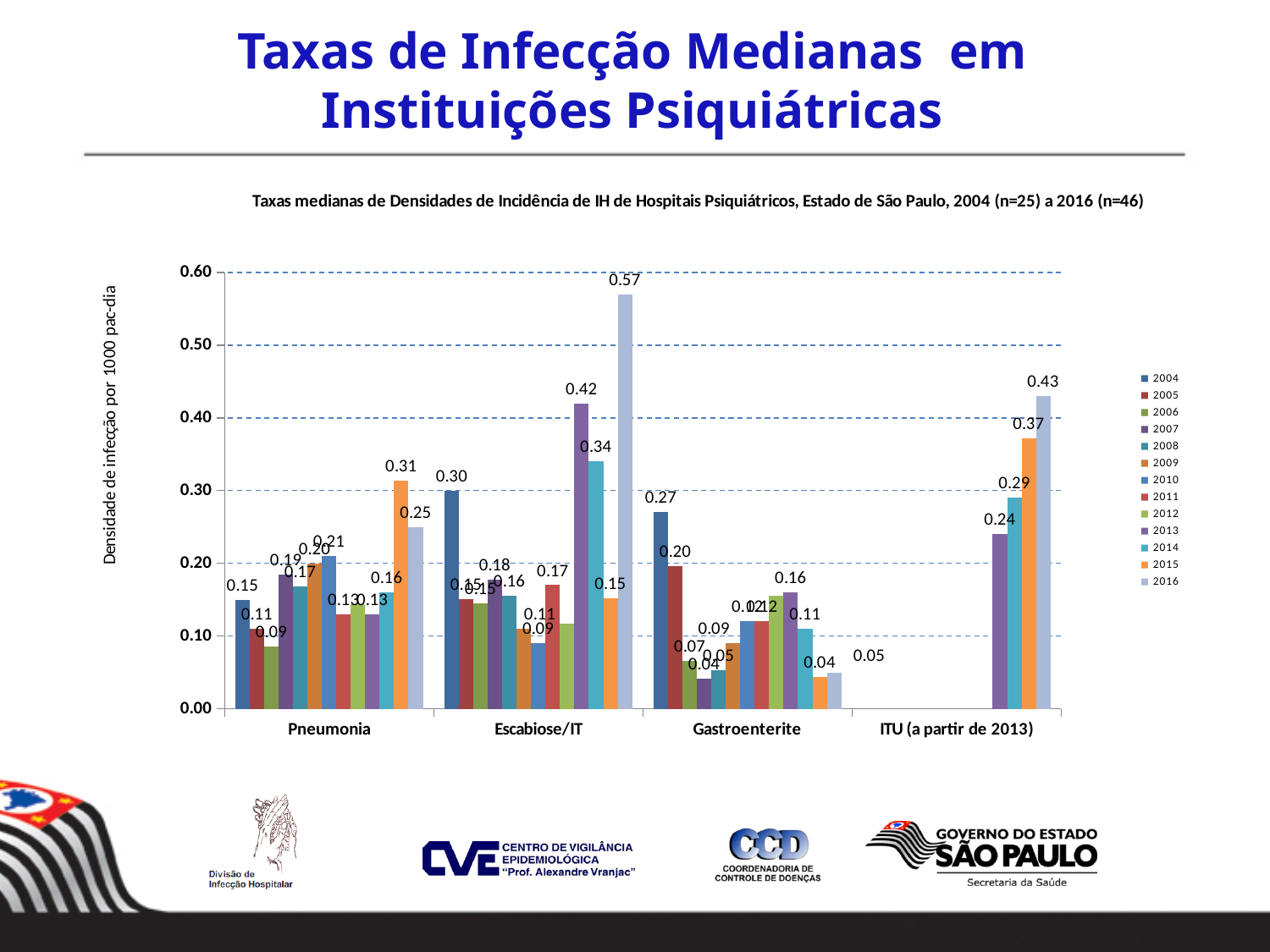
What type of chart is shown on the slide? bar chart Is the 2016 value for Escabiose/IT greater or less than 0.50? greater What is the 2016 value for ITU (a partir de 2013)? 0.43 Which is larger: the 2016 value for Escabiose/IT or the 2016 value for ITU (a partir de 2013)? Escabiose/IT What is the 2015 value for Pneumonia? 0.31 What is the difference between the 2016 and 2015 values for ITU (a partir de 2013)? 0.06 What is the 2016 value for Escabiose/IT? 0.57 How many infection categories are shown on the x axis? 4 What is the 2004 value for Gastroenterite? 0.27 How many series (years) does the legend list? 13 Which category has the highest 2016 value? Escabiose/IT Do the values for ITU (a partir de 2013) rise or fall from 2013 to 2016? rise